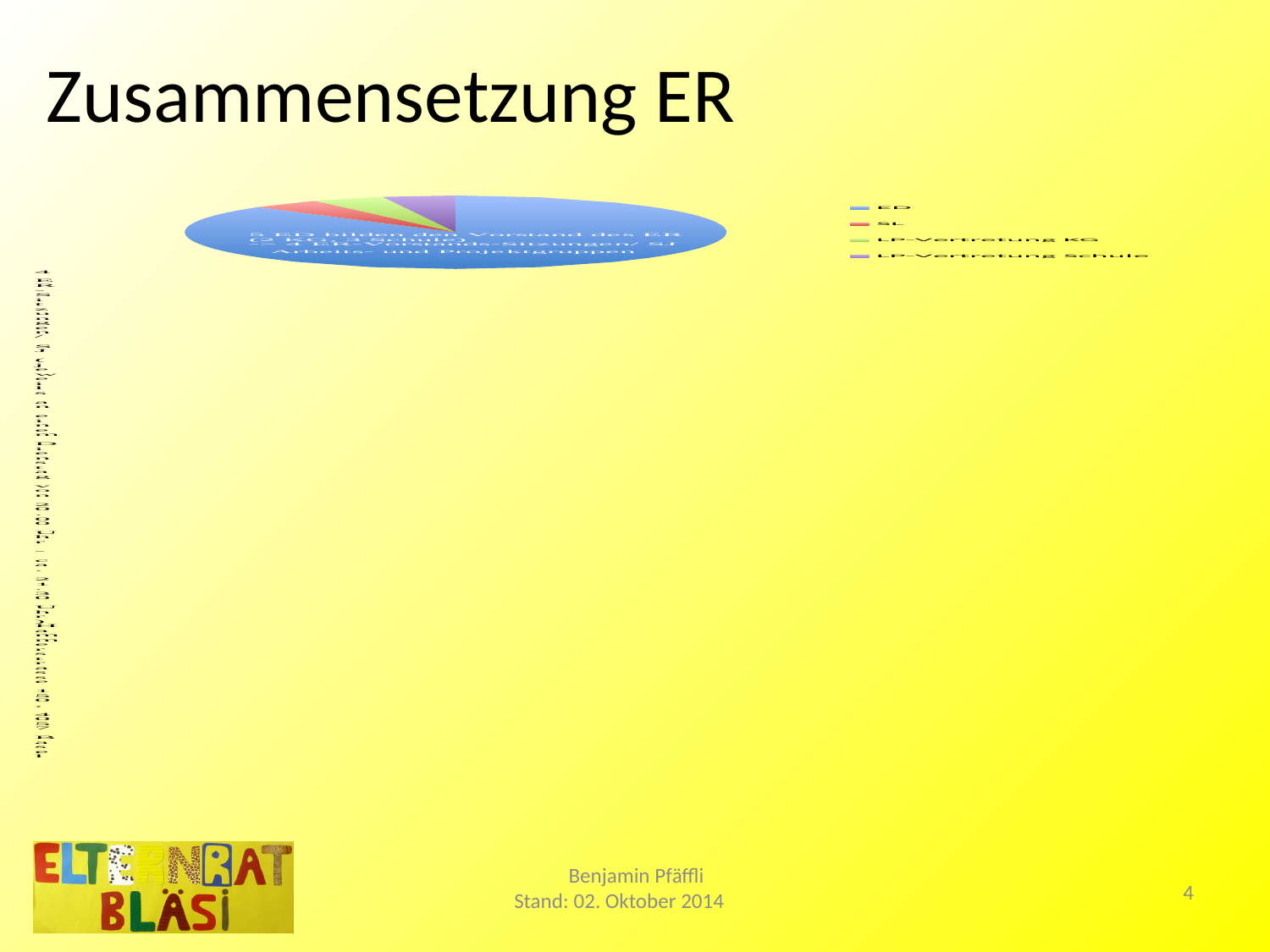
How many entries does the legend of the pie chart list? 4 Which category is shown in purple in the pie chart legend? LP-Vertretung Schule Which is larger in the pie chart, the slice for ED or the slice for SL? ED Which category has the largest slice in the pie chart? ED Which is larger in the pie chart, the slice for ED or the slice for LP-Vertretung Schule? ED Which colour represents ED in the pie chart legend? blue How many slices does the pie chart have? 4 What kind of chart is shown on the slide? pie chart